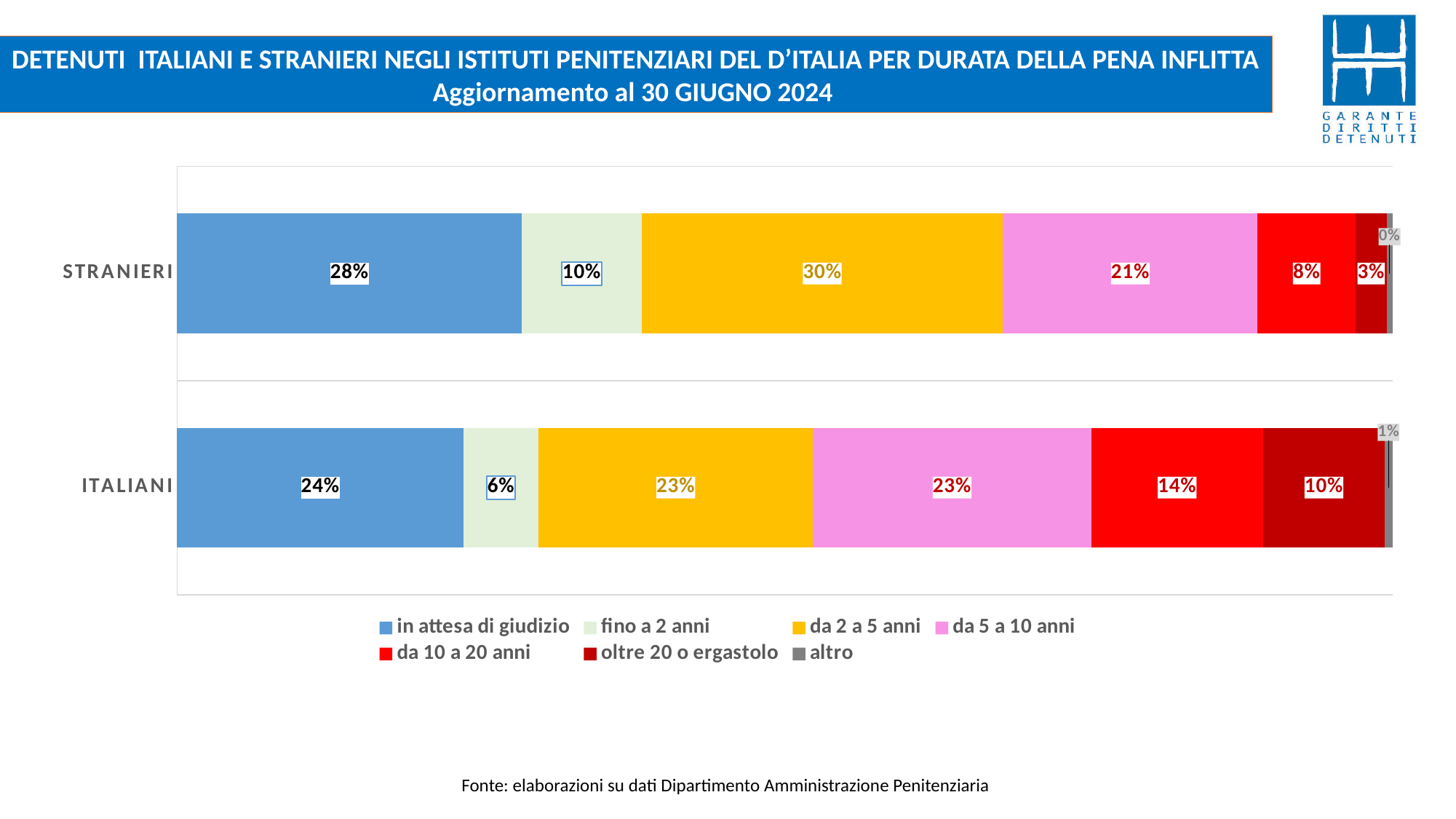
What is the value for 'oltre 20 o ergastolo' for STRANIERI? 3% What is the value for 'da 2 a 5 anni' for ITALIANI? 23% What is the value for 'in attesa di giudizio' for STRANIERI? 28% Which series has the highest value in the STRANIERI bar? da 2 a 5 anni Which colour represents the 'da 5 a 10 anni' series in the legend? Pink How many series does the legend list? 7 How many categories (bars) are shown in the chart? 2 What is the value for 'da 10 a 20 anni' for ITALIANI? 14% What is the difference between the 'fino a 2 anni' values for STRANIERI and ITALIANI? 4% What type of chart is shown on the slide? Stacked bar chart Which is larger: 'da 5 a 10 anni' for STRANIERI or 'da 5 a 10 anni' for ITALIANI? ITALIANI Which series has the lowest value in the ITALIANI bar? altro